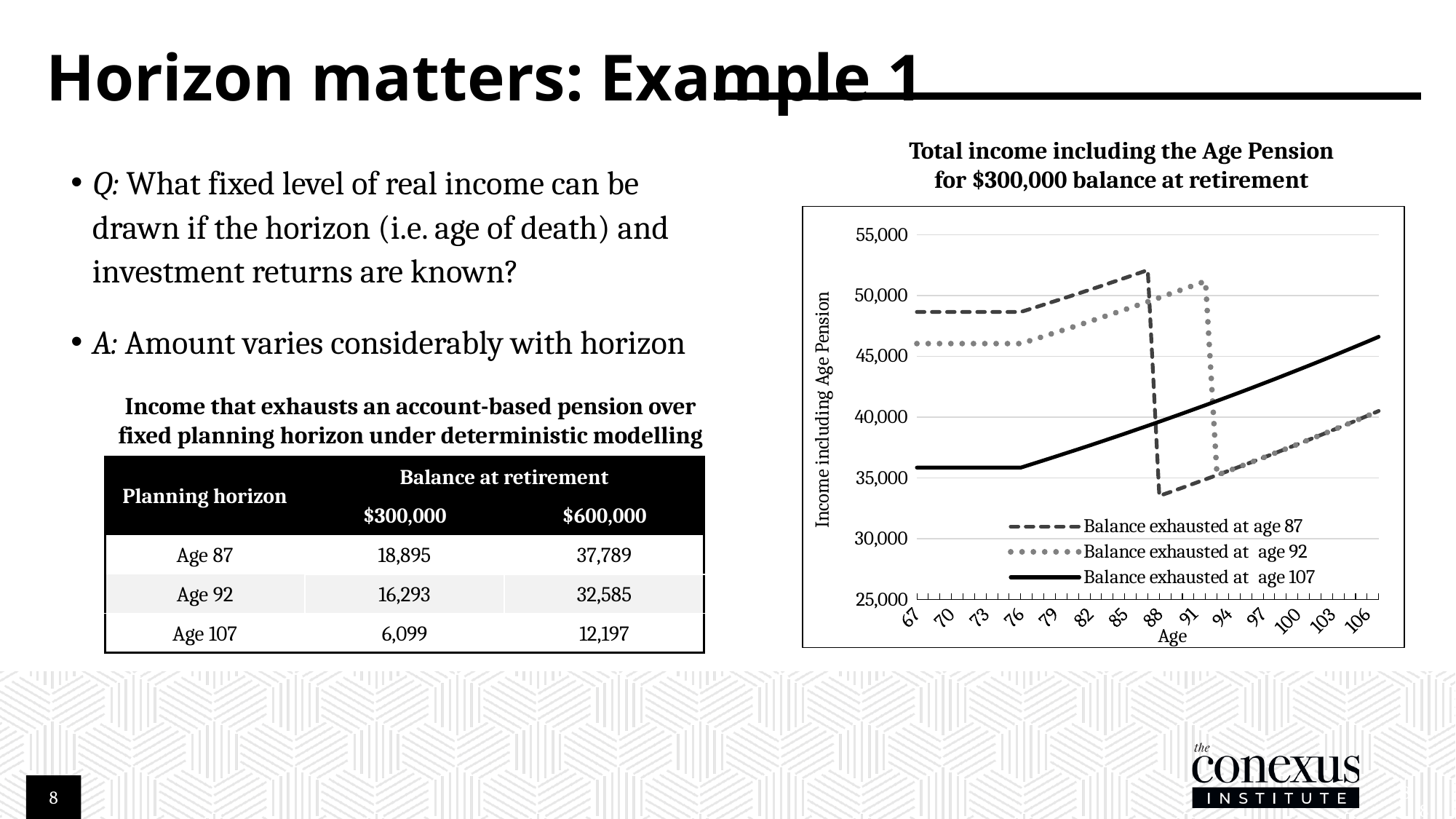
What is the label on the chart's vertical axis? Income including Age Pension Is the value of the 'Balance exhausted at age 107' series at age 106 greater or less than 45,000? greater Is the peak value of the 'Balance exhausted at age 92' series greater or less than 50,000? greater At age 67, which series is higher: 'Balance exhausted at age 87' or 'Balance exhausted at age 92'? Balance exhausted at age 87 Does the 'Balance exhausted at age 107' series rise or fall between age 76 and age 106? rise Is the value of the 'Balance exhausted at age 107' series at age 67 greater or less than 40,000? less How many series does the chart's legend list? 3 What is the title of the chart? Total income including the Age Pension for $300,000 balance at retirement What kind of chart is shown on the slide? line chart At age 106, which series is higher: 'Balance exhausted at age 107' or 'Balance exhausted at age 87'? Balance exhausted at age 107